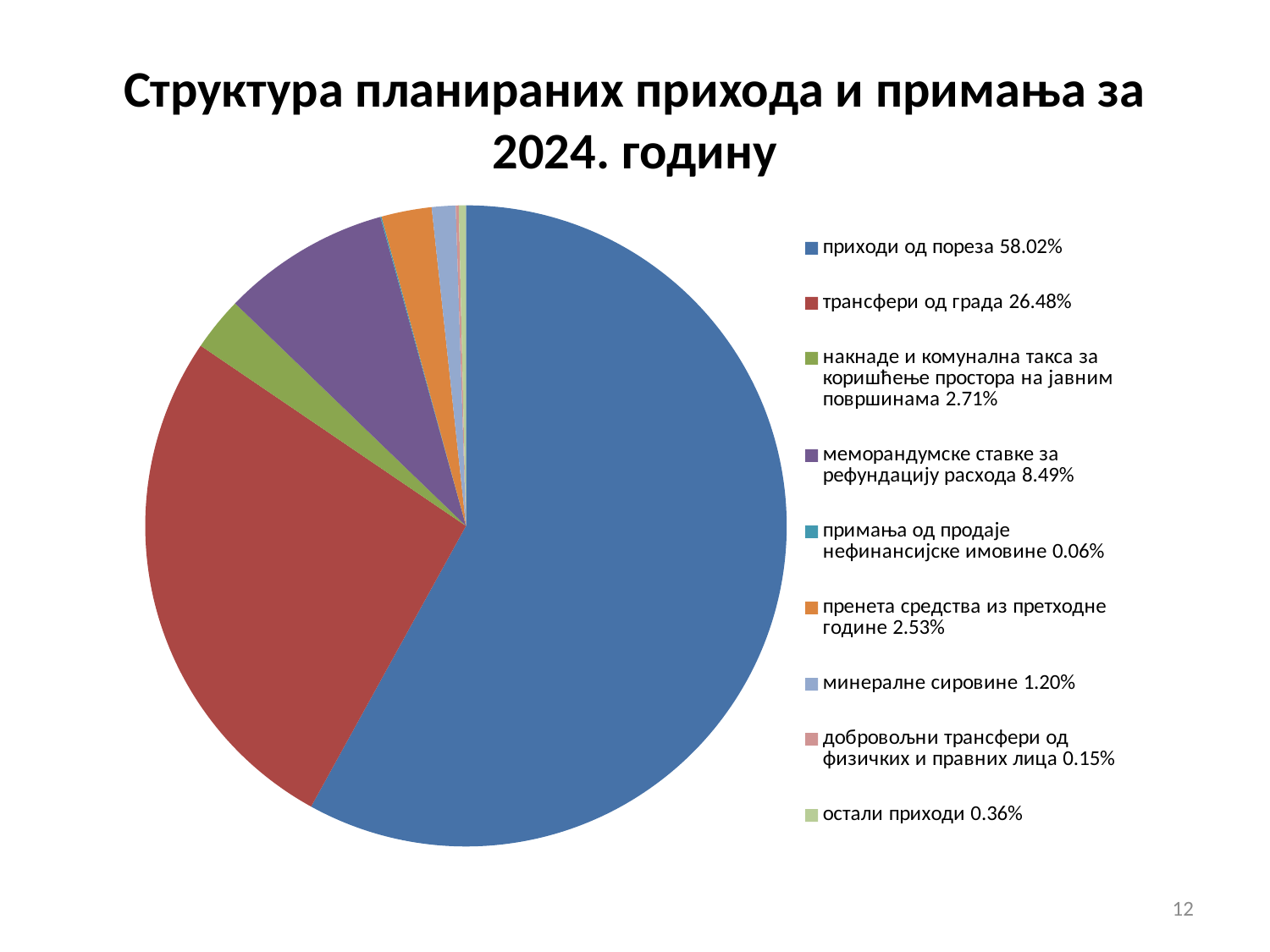
Which category has the smallest slice of the pie? примања од продаје нефинансијске имовине What kind of chart is shown on the slide? pie chart What is the title of the chart? Структура планираних прихода и примања за 2024. годину What is the difference between the shares of "приходи од пореза" and "трансфери од града"? 31.54% What share is shown for "трансфери од града"? 26.48% What share is shown for "меморандумске ставке за рефундацију расхода"? 8.49% Which category has the largest slice of the pie? приходи од пореза What colour is the slice for "трансфери од града"? red What share is shown for "минералне сировине"? 1.20% Which is larger: "накнаде и комунална такса за коришћење простора на јавним површинама" or "пренета средства из претходне године"? накнаде и комунална такса за коришћење простора на јавним површинама What share is shown for "приходи од пореза"? 58.02% How many categories does the legend list? 9